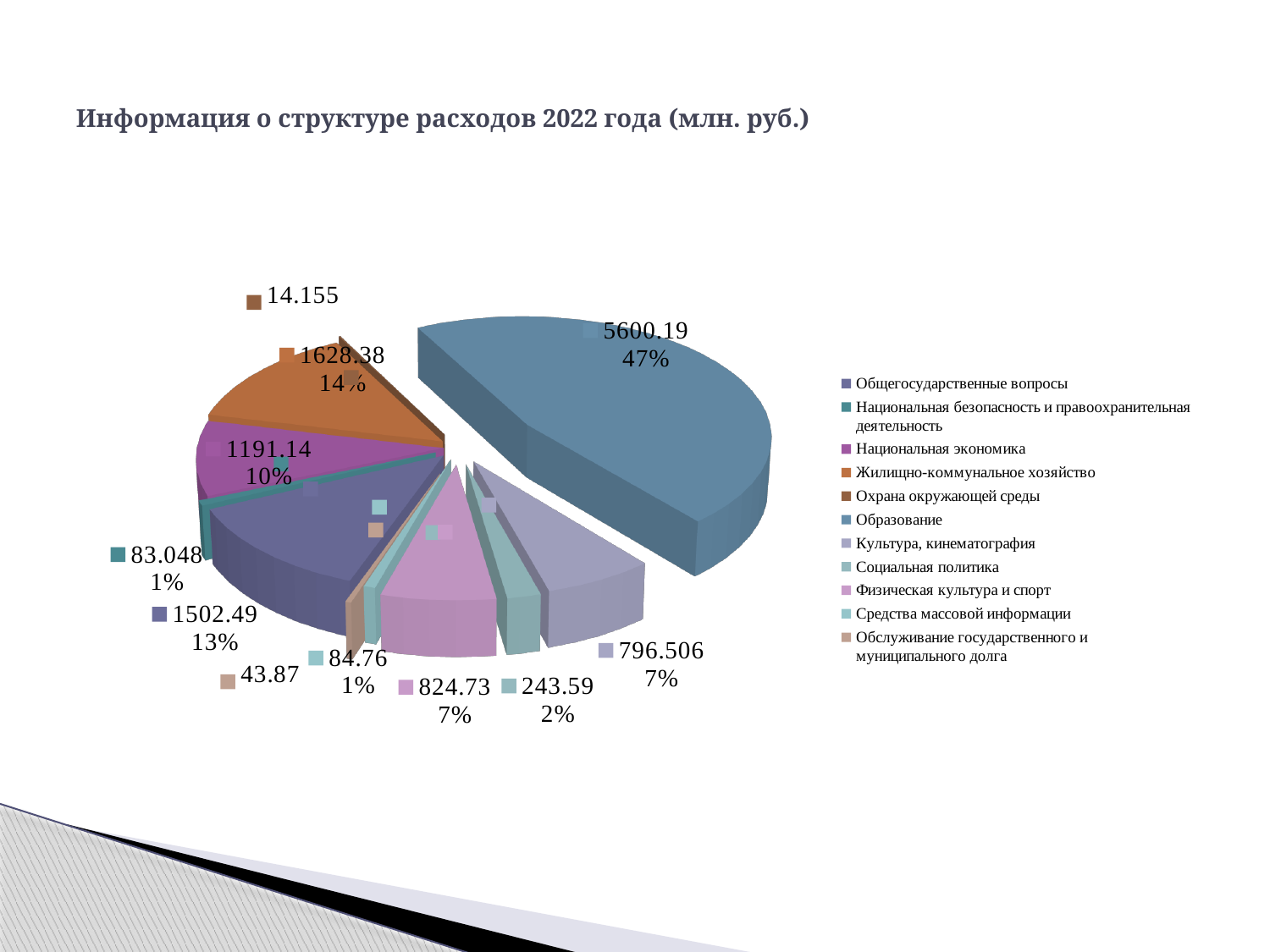
Which category has the largest value? Образование What is the value for Охрана окружающей среды? 14.155 How many categories does the legend list? 11 What is the value for Образование? 5600.19 What is the difference between the values for Жилищно-коммунальное хозяйство and Общегосударственные вопросы? 125.89 What is the title of the chart? Информация о структуре расходов 2022 года (млн. руб.) What share of the pie does Национальная экономика take? 10% What share of the pie does Образование take? 47% Which is larger, the value for Физическая культура и спорт or the value for Культура, кинематография? Физическая культура и спорт What kind of chart is shown on the slide? pie chart Which category has the smallest value? Охрана окружающей среды What is the value for Жилищно-коммунальное хозяйство? 1628.38